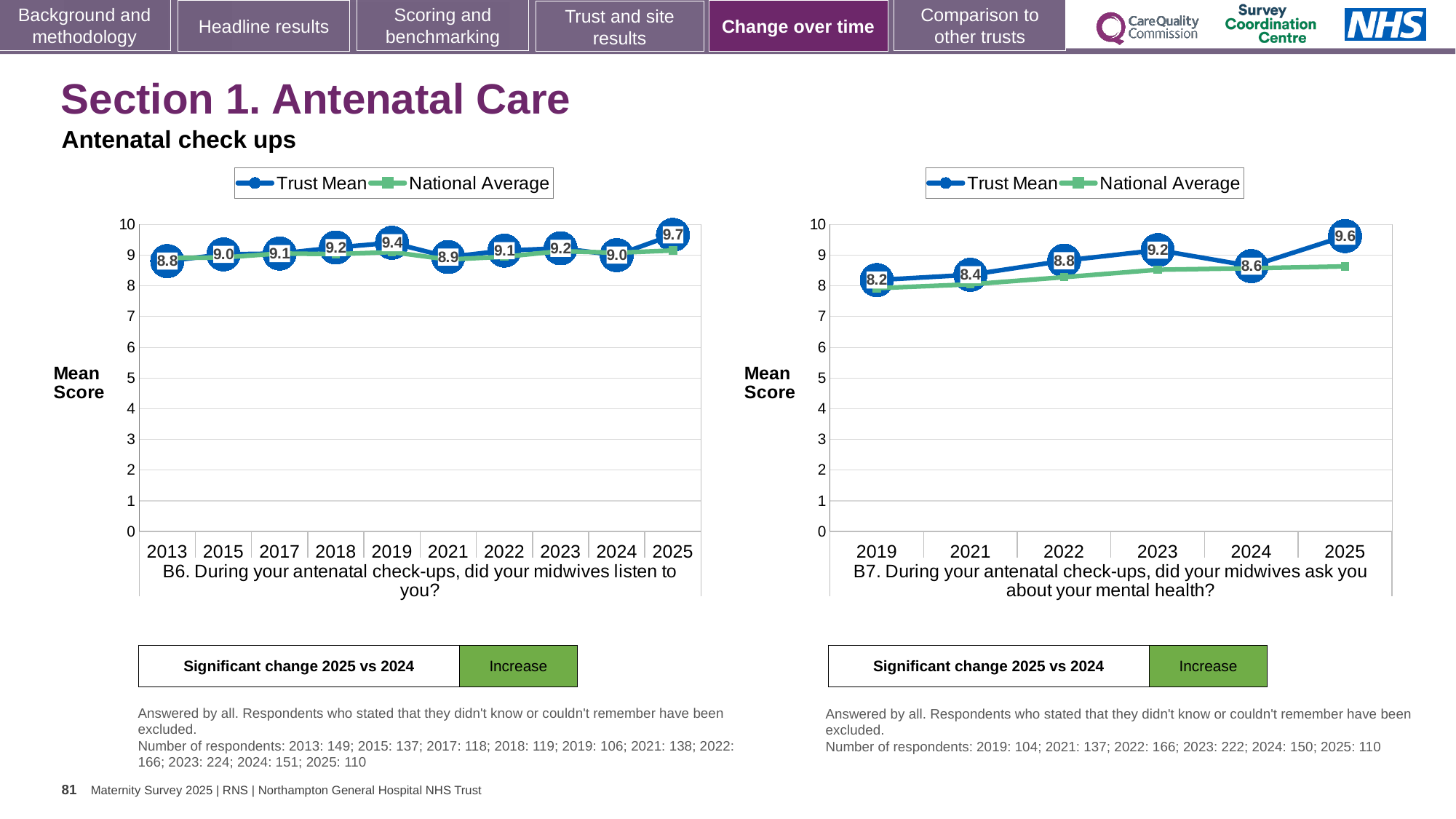
In the left chart (B6), which year has the highest Trust Mean? 2025 In the right chart (B7), which year has the lowest Trust Mean? 2019 In the left chart (B6), what is the Trust Mean for 2013? 8.8 How many series does the legend of the right chart (B7) list? 2 In the right chart (B7), what is the Trust Mean for 2023? 9.2 What kind of chart is the left chart (B6)? line chart In the right chart (B7), is the Trust Mean for 2024 larger or smaller than the Trust Mean for 2023? smaller In the left chart (B6), which year has the lowest Trust Mean? 2013 In the left chart (B6), what is the difference between the Trust Mean for 2025 and 2024? 0.7 In the left chart (B6), how many years are shown on the x axis? 10 In the left chart (B6), what is the Trust Mean for 2025? 9.7 In the right chart (B7), is the National Average for 2025 greater or less than 8? greater